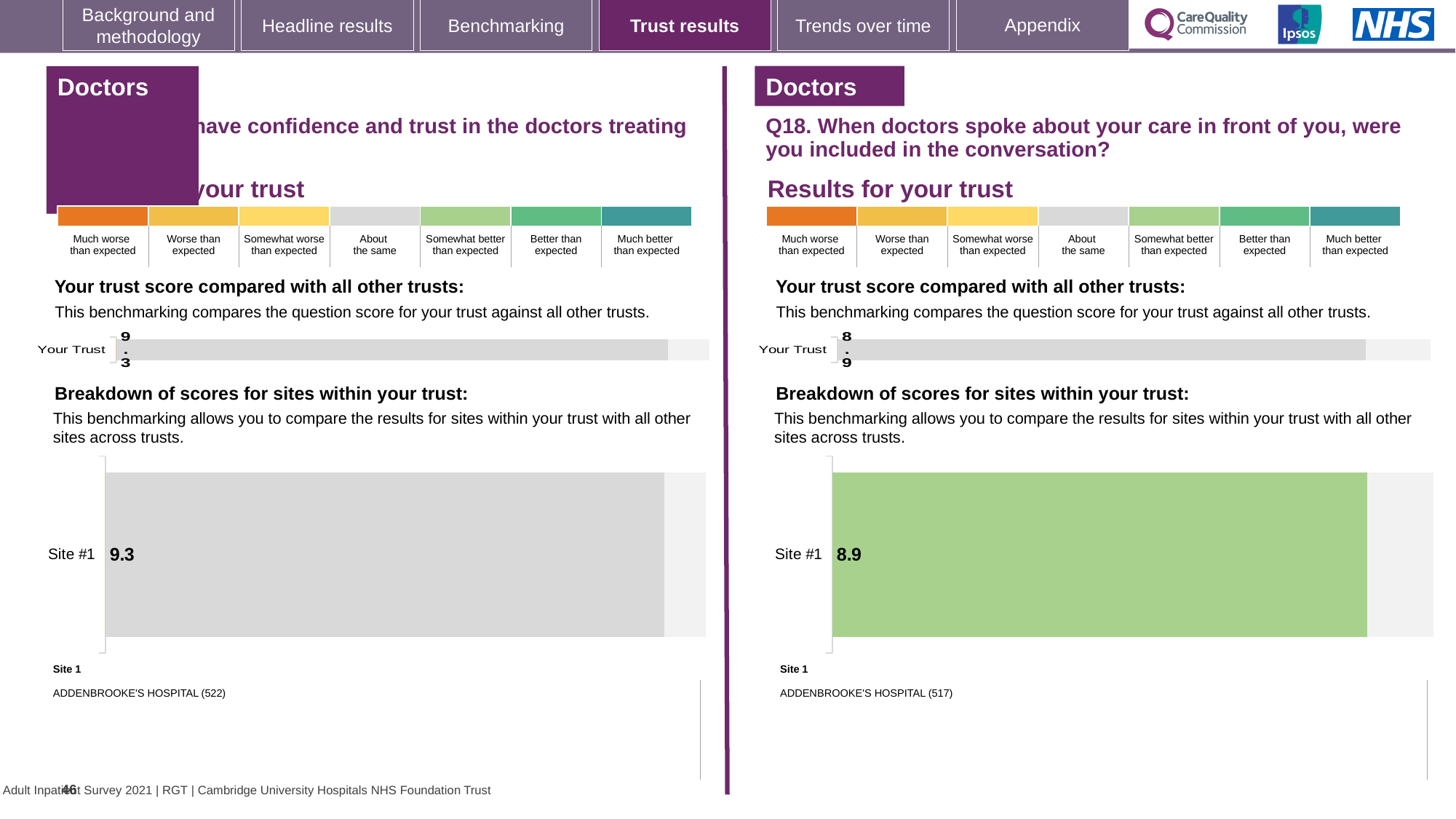
What colour is the Site #1 bar on the left half of the slide? Grey Which hospital is listed as Site 1 on the right half of the slide (Q18)? ADDENBROOKE'S HOSPITAL (517) On the left half of the slide, what is the score shown for Site #1? 9.3 On the left half of the slide, what is the score shown for Your Trust? 9.3 What is the difference between the Site #1 score on the left half of the slide and the Site #1 score on the right half (Q18)? 0.4 What kind of chart is used to show the Site #1 score on the right half of the slide? Bar chart On the right half of the slide (Q18), what is the score shown for Site #1? 8.9 What colour is the Site #1 bar on the right half of the slide (Q18)? Light green Which Site #1 score is larger: the one on the left half of the slide or the one on the right half (Q18)? Left half (9.3) How many sites are shown in the site breakdown chart on the left half of the slide? 1 On the right half of the slide (Q18), what is the score shown for Your Trust? 8.9 Is the Site #1 score on the right half of the slide (Q18) greater or less than the Site #1 score on the left half? less